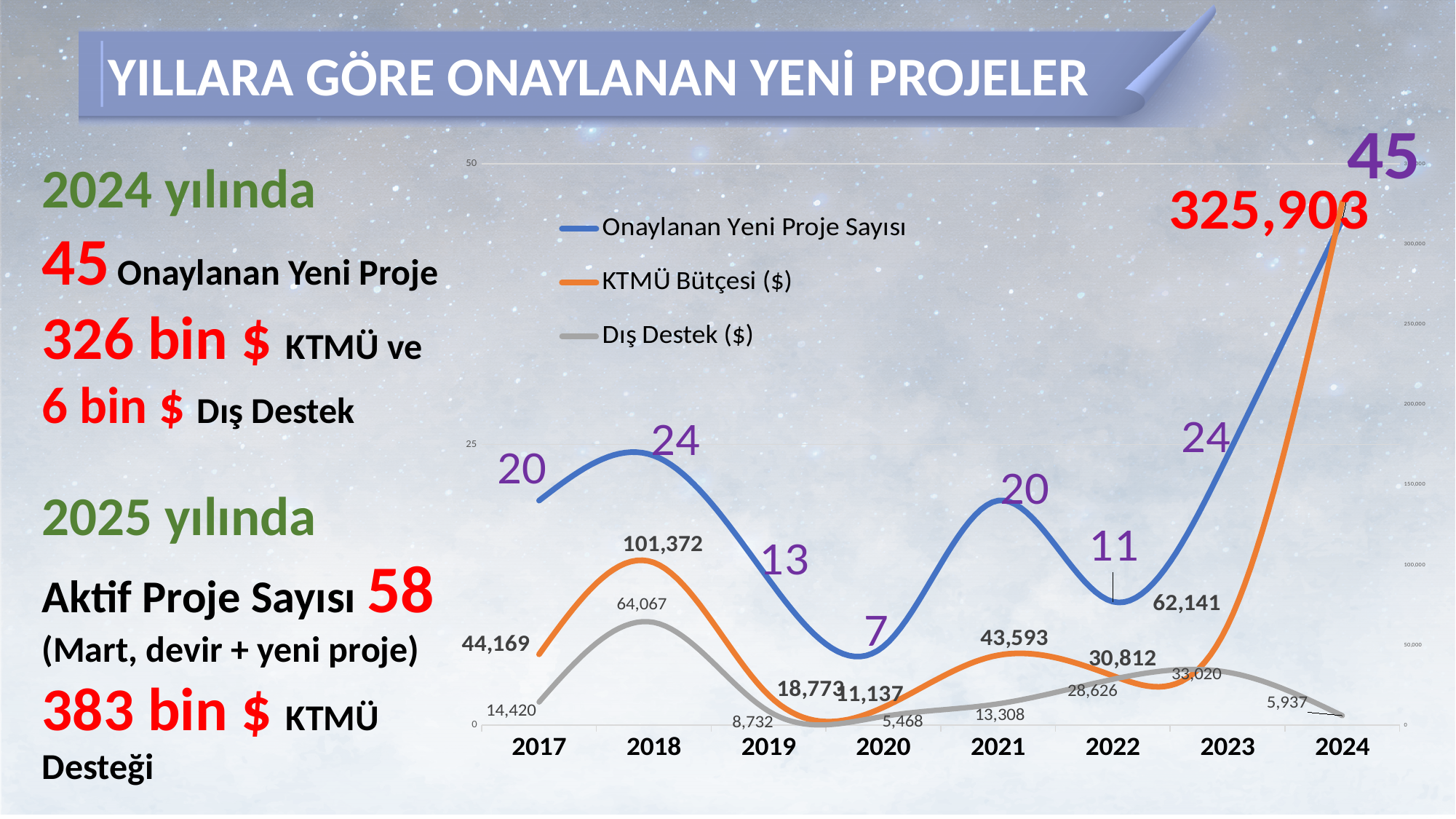
How many years are plotted along the x axis of the chart? 8 How many series does the chart legend list? 3 What is the difference between the Onaylanan Yeni Proje Sayısı in 2024 and in 2020? 38 Which year has the larger Onaylanan Yeni Proje Sayısı, 2018 or 2019? 2018 What is the title of the chart slide? YILLARA GÖRE ONAYLANAN YENİ PROJELER In which year is the Onaylanan Yeni Proje Sayısı lowest? 2020 What is the KTMÜ Bütçesi ($) value for 2018? 101,372 What is the Dış Destek ($) value for 2018? 64,067 What is the Onaylanan Yeni Proje Sayısı value for 2020? 7 In which year is the Onaylanan Yeni Proje Sayısı highest? 2024 What is the Onaylanan Yeni Proje Sayısı value for 2024? 45 What kind of chart is shown on the slide? line chart